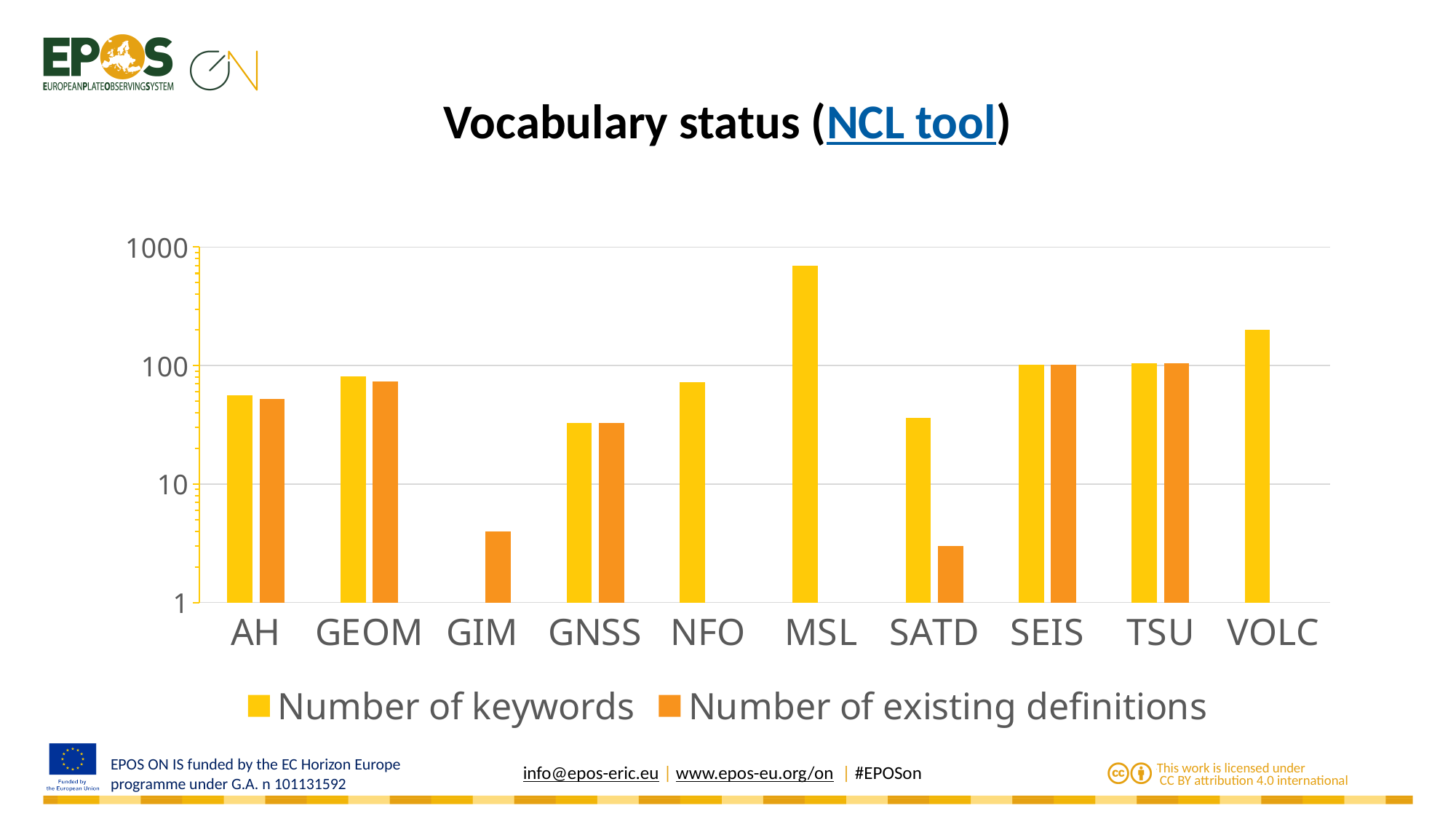
Is the number of existing definitions for GIM greater or less than 10? less How many categories are shown on the x axis of the chart? 10 How many series does the chart's legend list? 2 What kind of chart is shown on the slide? bar chart Which category has the highest number of keywords? MSL For SATD, which is larger: the number of keywords or the number of existing definitions? Number of keywords Is the number of keywords for VOLC greater or less than 100? greater Which is larger, the number of keywords for MSL or the number of keywords for VOLC? MSL What is the title of the slide containing the chart? Vocabulary status (NCL tool) Is the number of keywords for AH greater or less than 100? less